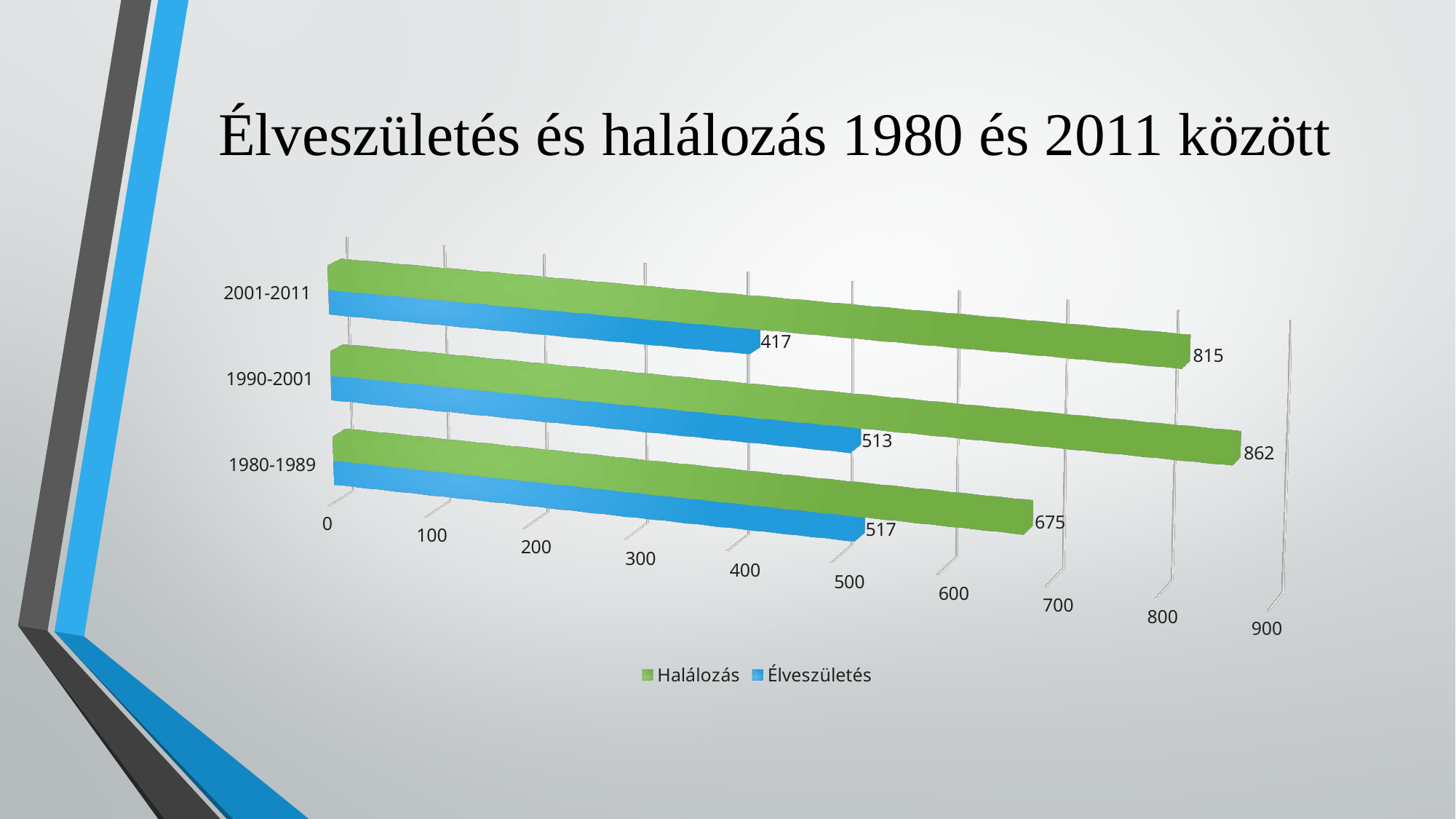
How many series does the legend list? 2 What kind of chart is shown on the slide? Bar chart What is the Halálozás value for 1990-2001? 862 What is the Halálozás value for 1980-1989? 675 How many periods are shown on the chart? 3 What is the Élveszületés value for 1990-2001? 513 What is the Élveszületés value for 2001-2011? 417 Which period has the lowest Élveszületés value? 2001-2011 What colour represents the Élveszületés series? Blue What is the difference between Halálozás and Élveszületés for 2001-2011? 398 Which is larger for 1980-1989, Halálozás or Élveszületés? Halálozás Which period has the highest Halálozás value? 1990-2001